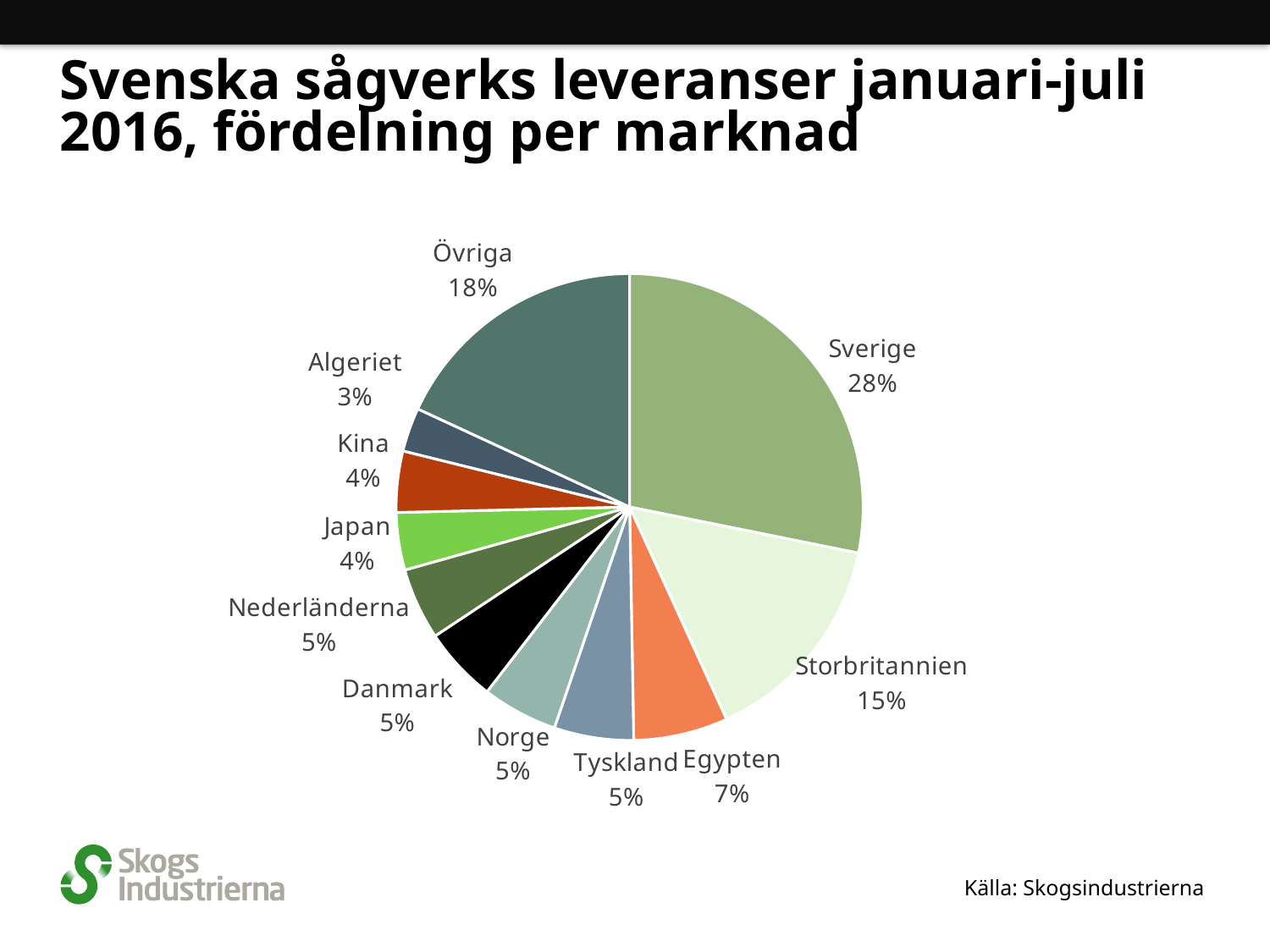
What is the value labelled for Egypten? 7% How many slices does the pie chart have? 11 What percentage is shown for Storbritannien? 15% Which market has the smallest slice of the pie? Algeriet Which is larger, the share for Övriga or the share for Storbritannien? Övriga What kind of chart is shown on the slide? Pie chart What share of the pie does Sverige account for? 28% Which is larger, the share for Egypten or the share for Tyskland? Egypten What percentage is shown for Övriga? 18% Which market has the largest slice of the pie? Sverige How many percentage points larger is Sverige's share than Storbritannien's? 13 What is the title of the slide? Svenska sågverks leveranser januari-juli 2016, fördelning per marknad